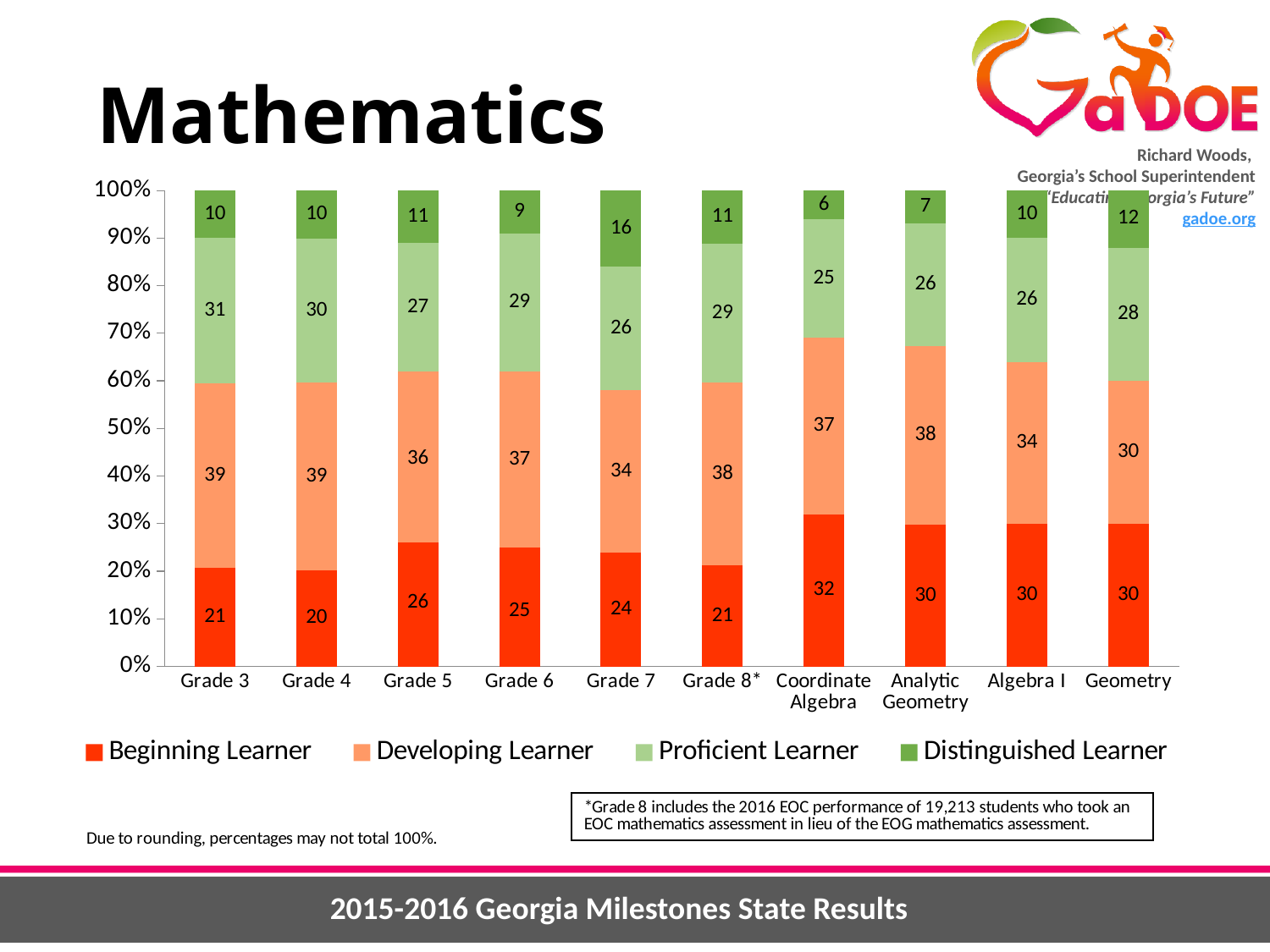
What percentage of Grade 3 students are Beginning Learners? 21 How many categories are shown on the x axis? 10 Which is larger, the Developing Learner value for Grade 5 or for Geometry? Grade 5 Which category has the highest Distinguished Learner percentage? Grade 7 What kind of chart is shown on the slide? Stacked bar chart Which category has the lowest Distinguished Learner percentage? Coordinate Algebra Which category has the highest Beginning Learner percentage? Coordinate Algebra What is the Distinguished Learner value for Grade 7? 16 What is the sum of the four printed values for Grade 5? 100 What is the Developing Learner value for Analytic Geometry? 38 What is the difference between the Proficient Learner values for Grade 3 and Grade 5? 4 How many series does the legend list? 4